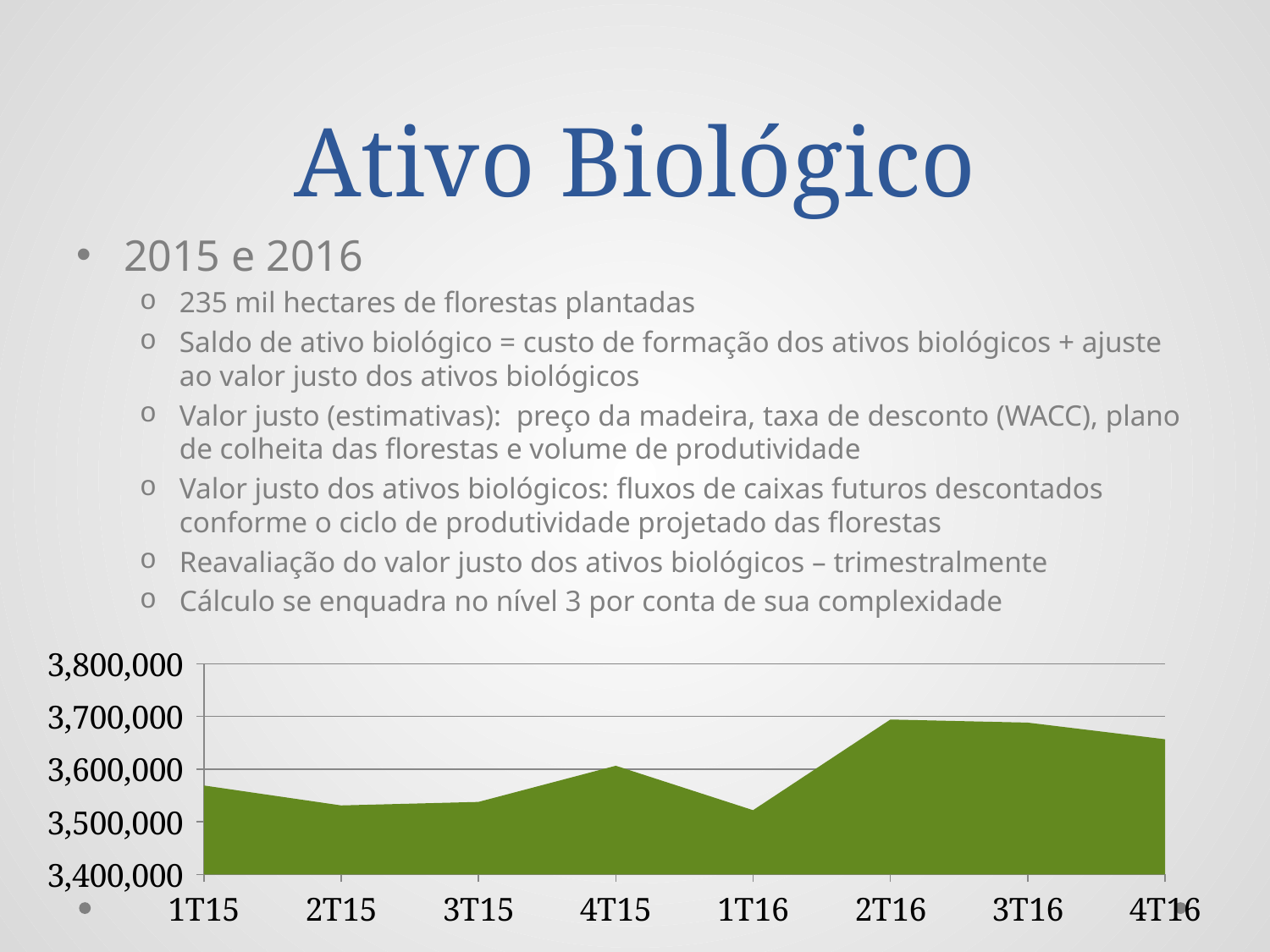
What is the highest value shown on the y axis of the chart? 3,800,000 What kind of chart is shown at the bottom of the slide? Area chart Does the value rise or fall from 1T16 to 2T16? rise How many quarters are plotted along the x axis of the chart? 8 Is the value for 1T15 greater or less than 3,600,000? less Is the value for 1T16 greater or less than 3,600,000? less Which is larger, the value for 4T16 or the value for 1T15? 4T16 Which is larger, the value for 2T16 or the value for 1T16? 2T16 Is the value for 2T16 greater or less than 3,600,000? greater What is the first quarter label on the x axis of the chart? 1T15